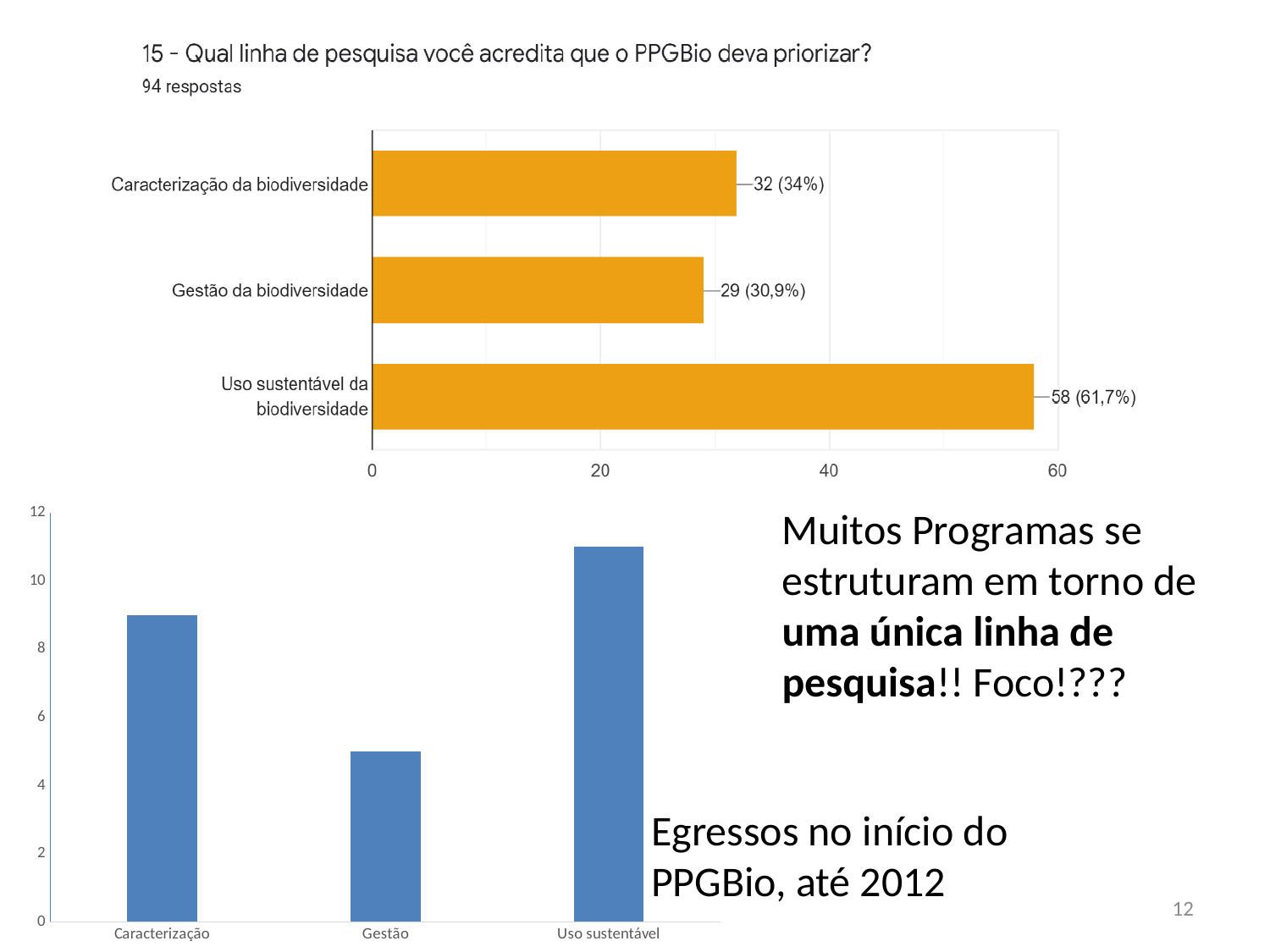
In the top chart, what is the value shown for 'Gestão da biodiversidade'? 29 (30,9%) In the top chart, what is the difference in responses between 'Uso sustentável da biodiversidade' and 'Caracterização da biodiversidade'? 26 In the bottom chart, is the value for 'Uso sustentável' greater or less than 10? greater In the top chart, how many responses chose 'Uso sustentável da biodiversidade'? 58 (61,7%) In the top chart, what percentage is shown for 'Caracterização da biodiversidade'? 34% In the top chart, how many categories are shown? 3 In the bottom chart, is the bar for 'Caracterização' taller or shorter than the bar for 'Uso sustentável'? shorter In the bottom chart, is the value for 'Gestão' greater or less than 6? less In the bottom chart, which category has the lowest bar? Gestão What type of chart is the top chart? bar chart In the top chart, which research line received the fewest responses? Gestão da biodiversidade In the top chart, which research line received the most responses? Uso sustentável da biodiversidade